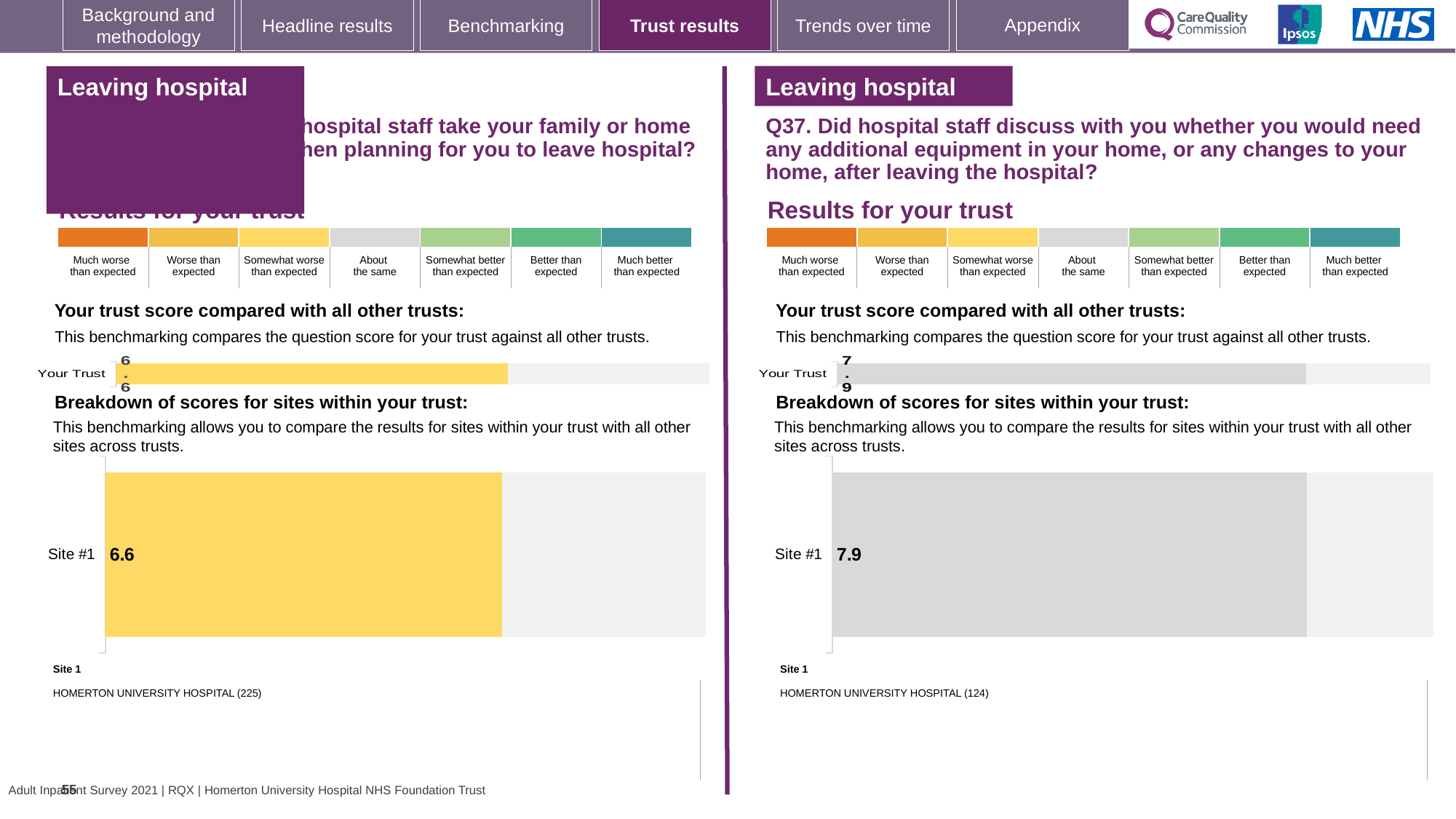
What is the difference between the Site #1 score on the right chart (Q37) and the Site #1 score on the left chart? 1.3 What kind of chart is used to show the Site #1 score on the right chart (Q37)? Bar chart On the right chart (Q37), what is the 'Your Trust' score? 7.9 On the left chart, which site name is listed as Site 1? HOMERTON UNIVERSITY HOSPITAL (225) How many sites are shown in the site breakdown chart on the right (Q37)? 1 Which is larger: the Site #1 score on the left chart or the Site #1 score on the right chart (Q37)? Right chart (Q37), 7.9 How many sites are shown in the site breakdown chart on the left? 1 On the left chart, what is the score shown for Site #1? 6.6 On the left chart, what is the 'Your Trust' score? 6.6 On the right chart (Q37), is the Site #1 score greater or less than 7? greater On the right chart (Q37), which site name is listed as Site 1? HOMERTON UNIVERSITY HOSPITAL (124) On the right chart (Q37), what is the score shown for Site #1? 7.9